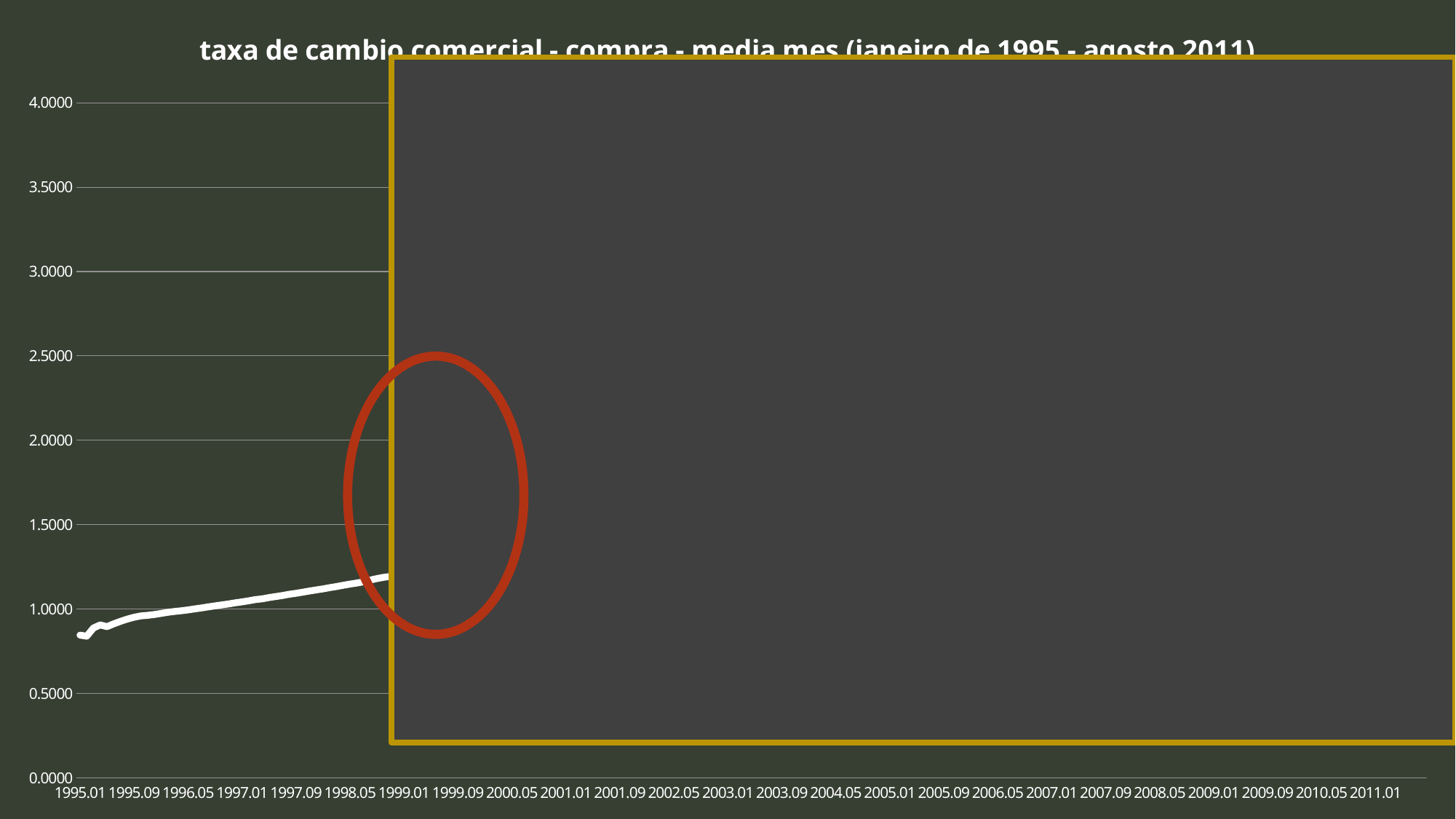
Is the value for 1995.01 greater or less than 0.5000? greater Which is larger, the value for 1995.01 or the value for 1998.05? 1998.05 What kind of chart is shown on the slide? line chart What is the first label on the horizontal axis? 1995.01 Is the value for 1998.05 greater or less than 1.0000? greater In the visible part of the chart, do the values rise or fall from 1995.01 to 1998.05? rise Is the value for 1998.05 greater or less than 1.5000? less What is the highest tick value shown on the vertical axis? 4.0000